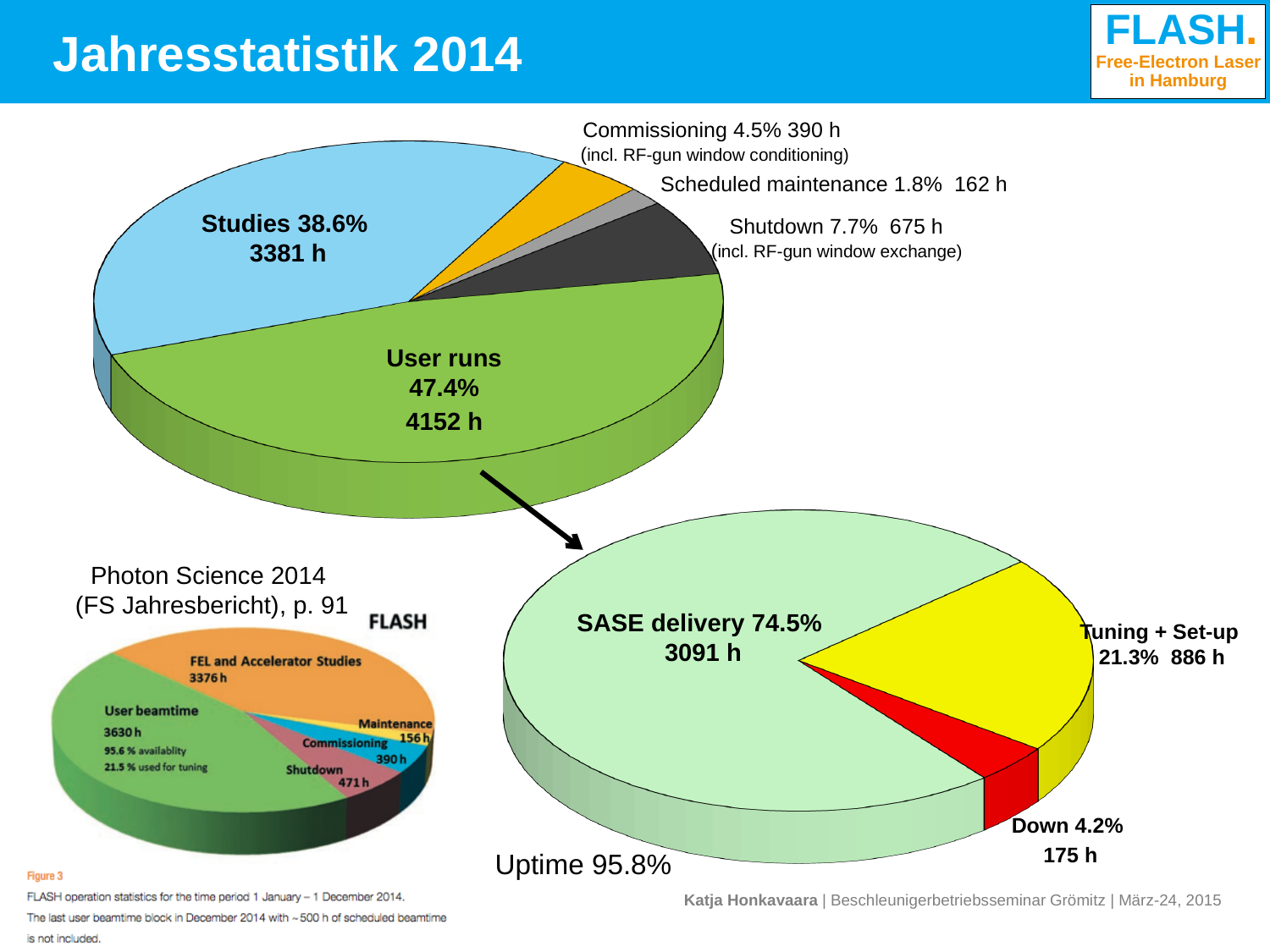
What kind of chart is the bottom-right chart showing SASE delivery? Pie chart In the top-left pie chart, how many hours are shown for Studies? 3381 h How many categories does the top-left pie chart show? 5 In the bottom-right pie chart, what share of the pie is Down? 4.2% In the bottom-right pie chart, how many hours are shown for Tuning + Set-up? 886 h In the top-left pie chart, what percentage share is shown for User runs? 47.4% In the top-left pie chart, which category has the largest share? User runs How many categories does the bottom-right pie chart show? 3 In the top-left pie chart, how many more hours are shown for User runs than for Studies? 771 h In the bottom-right pie chart, which is larger: SASE delivery or Tuning + Set-up? SASE delivery In the top-left pie chart, which category has the smallest share? Scheduled maintenance In the small bottom-left pie chart (Photon Science 2014), how many hours are shown for User beamtime? 3630 h